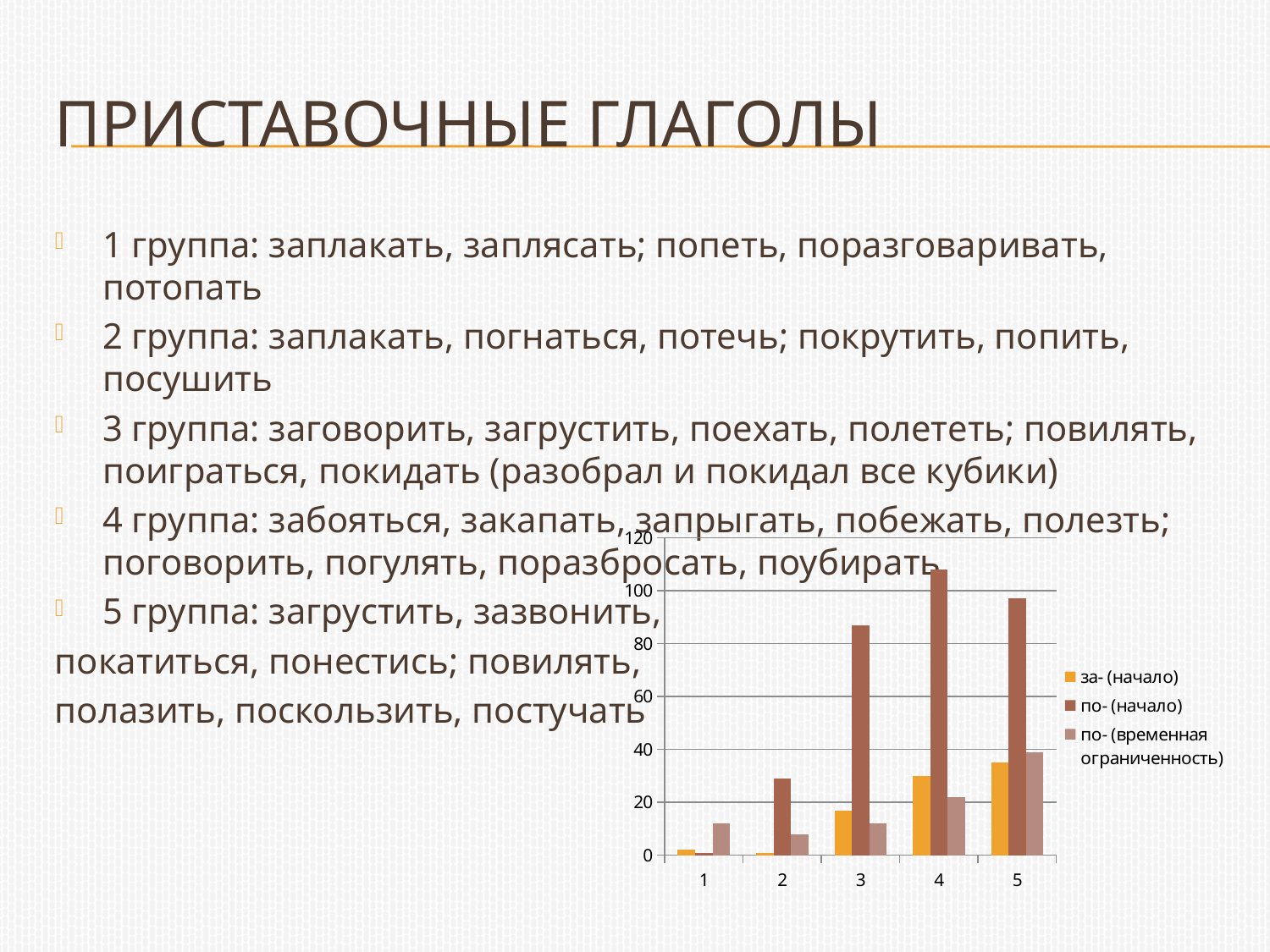
For the series по- (начало), which category has the lowest bar? 1 In category 5, which is larger: за- (начало) or по- (начало)? по- (начало) Is the value for по- (временная ограниченность) in category 1 greater or less than 20? less How many categories are shown on the x axis of the chart? 5 Which series is shown in orange in the chart's legend? за- (начало) Is the value for по- (начало) in category 3 greater or less than 80? greater Is the value for за- (начало) in category 5 greater or less than 40? less For the series за- (начало), which category has the highest bar? 5 How many series does the chart's legend list? 3 For the series по- (начало), which category has the highest bar? 4 What kind of chart is shown on the slide? bar chart